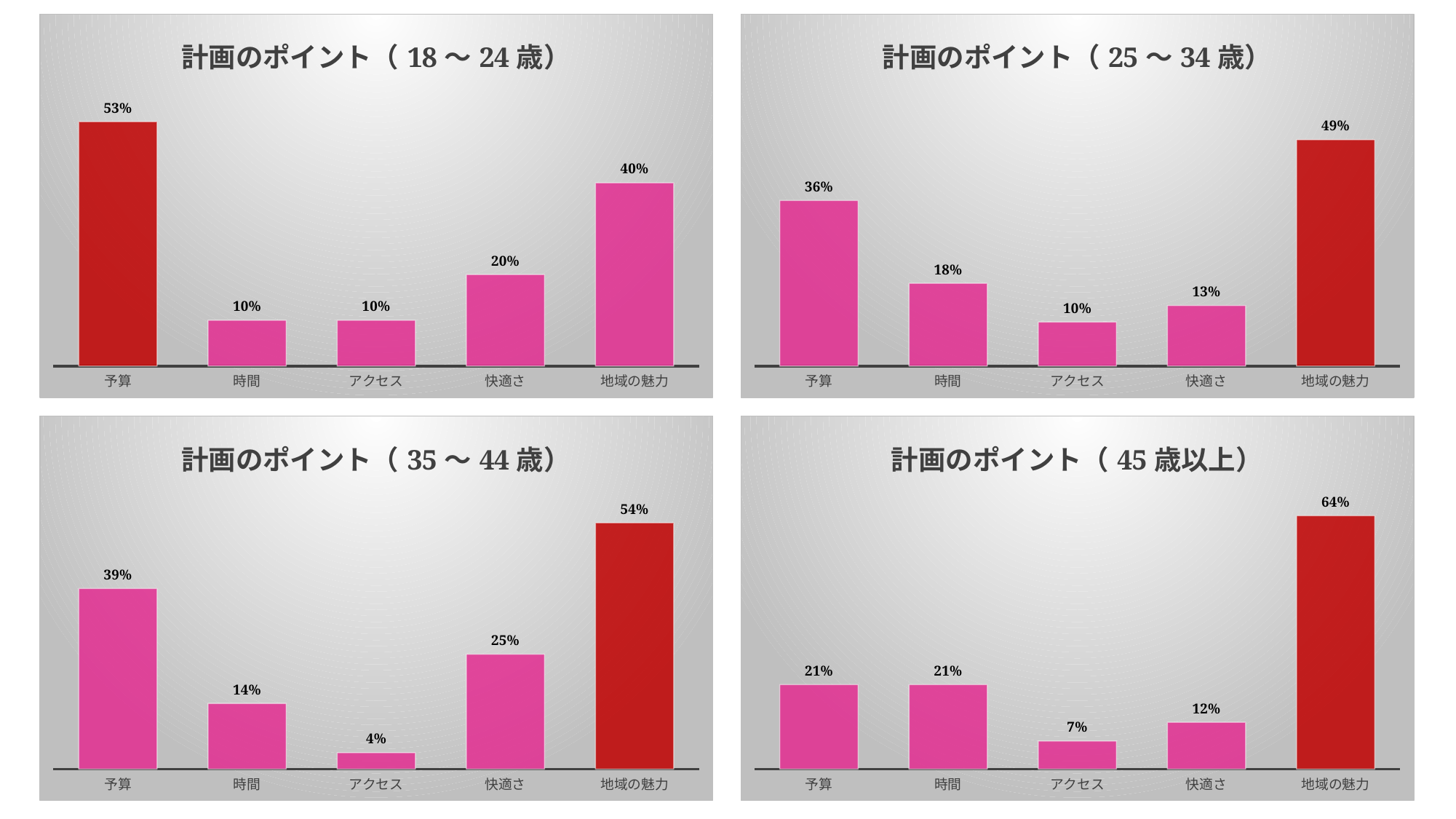
In the chart titled 計画のポイント（45歳以上）, what is the difference between 地域の魅力 and 予算? 43% In the chart titled 計画のポイント（25～34歳）, which category has the highest value? 地域の魅力 In the chart titled 計画のポイント（18～24歳）, what is the value for 予算? 53% In the chart titled 計画のポイント（35～44歳）, which category has the lowest value? アクセス In the chart titled 計画のポイント（18～24歳）, which bar is coloured red rather than pink? 予算 How many categories are shown in the chart titled 計画のポイント（35～44歳）? 5 In the chart titled 計画のポイント（45歳以上）, what is the value for アクセス? 7% How many charts are on the slide? 4 In the chart titled 計画のポイント（18～24歳）, which is larger, 快適さ or 地域の魅力? 地域の魅力 What kind of chart is the chart titled 計画のポイント（45歳以上）? bar chart In the chart titled 計画のポイント（25～34歳）, what is the value for 快適さ? 13% In the chart titled 計画のポイント（35～44歳）, what is the difference between 地域の魅力 and 快適さ? 29%